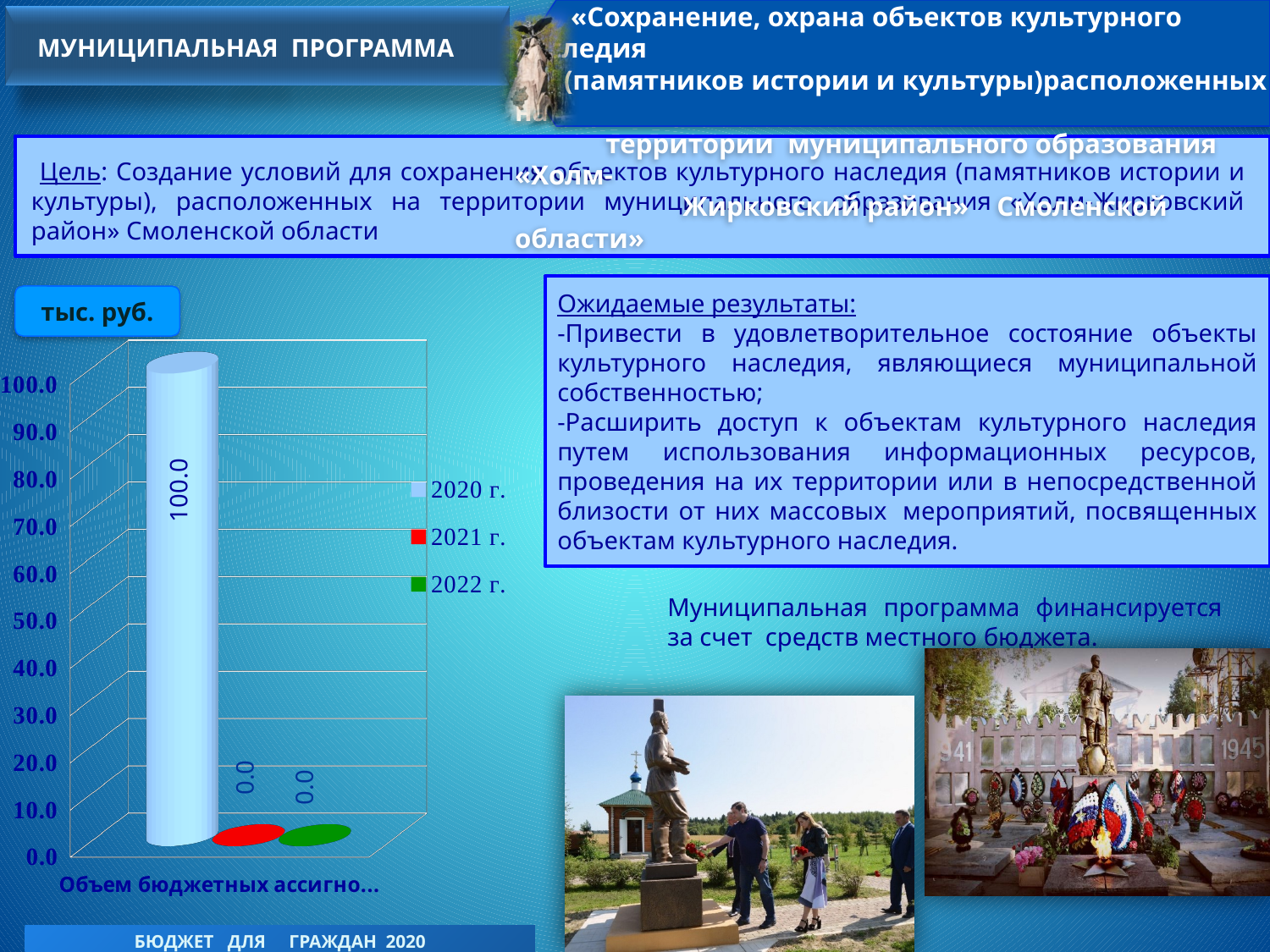
What is the value for 2020 г. on the chart? 100.0 What unit is indicated for the chart values? тыс. руб. What colour is used for the 2021 г. series in the legend? red What is the difference between the values for 2020 г. and 2021 г.? 100.0 What kind of chart is shown on the slide? bar chart What is the value for 2022 г. on the chart? 0.0 How many series does the chart legend list? 3 What is the value for 2021 г. on the chart? 0.0 Is the value for 2020 г. greater or less than 50.0? greater What is the highest value shown on the chart's vertical axis? 100.0 Which year has the highest value on the chart? 2020 г. Which is larger, the value for 2020 г. or the value for 2022 г.? 2020 г.